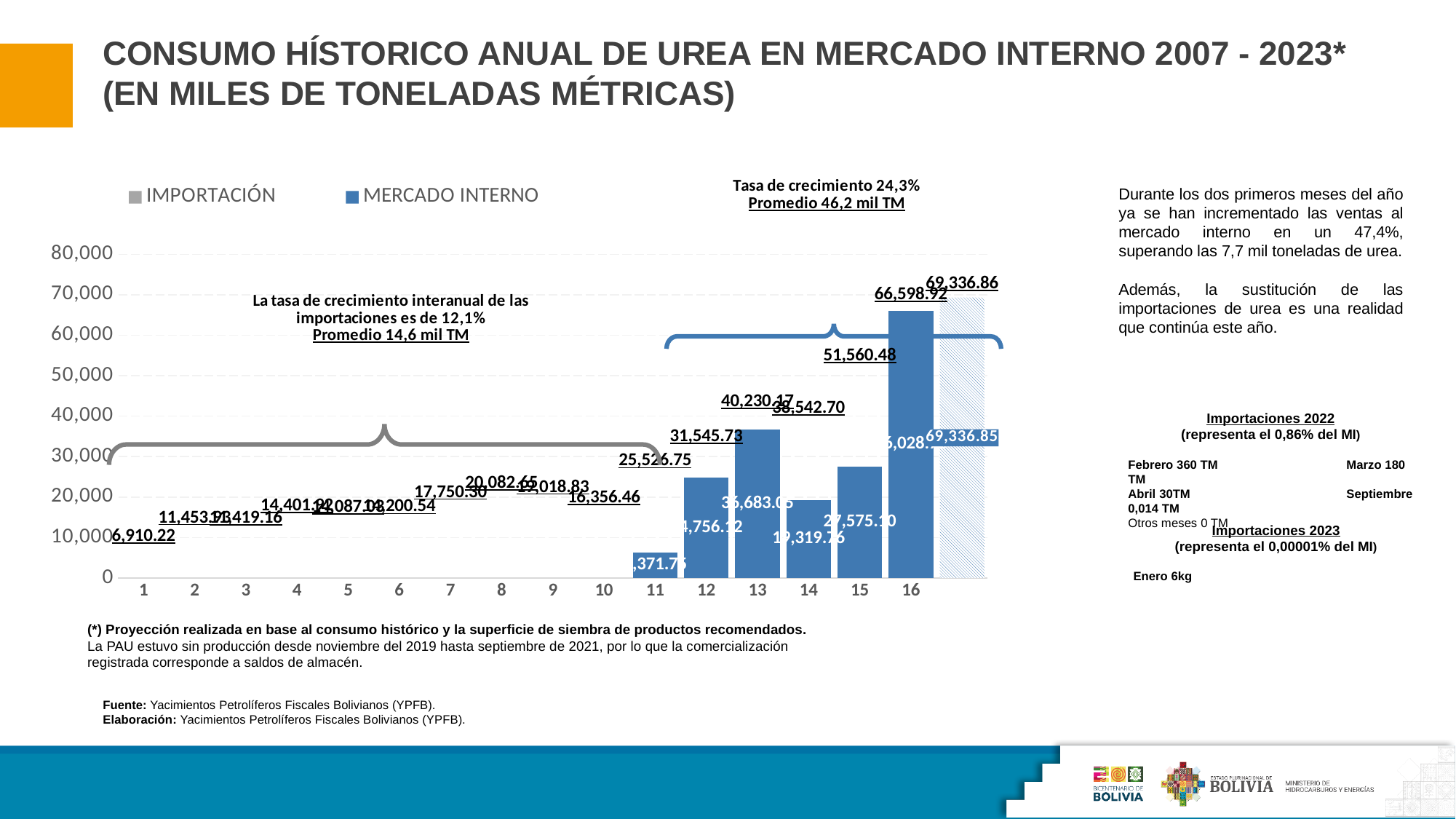
How many series does the chart legend list? 2 Is the blue MERCADO INTERNO bar at category 14 greater or less than 30,000? less What is the underlined data label shown at category 1? 6,910.22 What are the two series named in the chart legend? IMPORTACIÓN and MERCADO INTERNO What is the underlined data label shown at category 12? 31,545.73 What is the difference between the underlined data labels at category 16 (66,598.92) and category 15 (51,560.48)? 15,038.44 Which is larger, the underlined data label at category 13 or at category 14? category 13 What is the underlined data label shown at category 7? 17,750.30 How many numbered categories are labeled on the x axis of the chart? 16 What is the underlined data label shown at category 15? 51,560.48 What is the underlined data label shown at category 16? 66,598.92 What type of chart is shown on the slide? bar chart